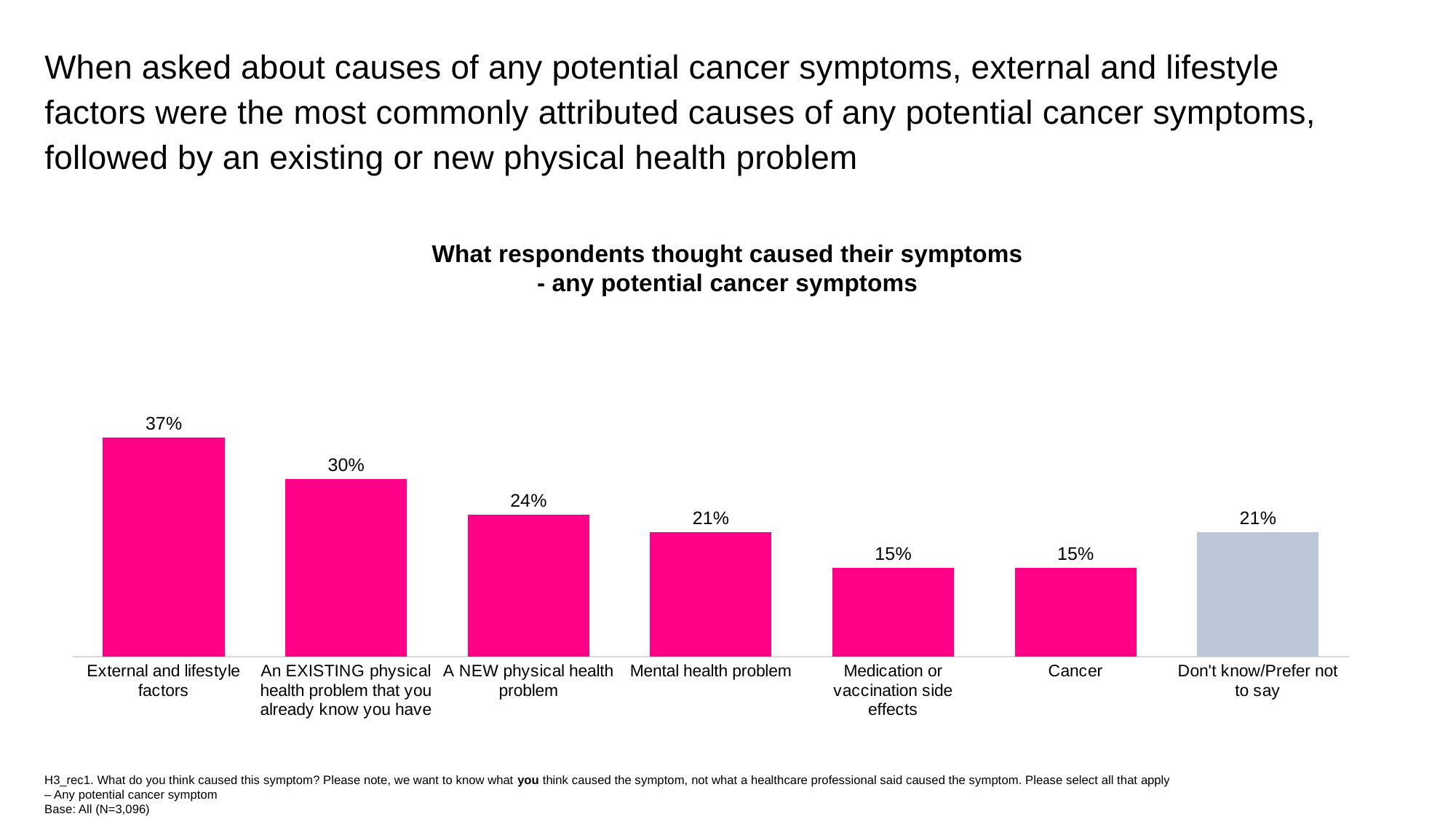
What is the value for 'Don't know/Prefer not to say'? 21% What is the value for 'A NEW physical health problem'? 24% How many categories are shown in the chart? 7 What kind of chart is shown on the slide? Bar chart What is the difference between the values for 'Mental health problem' and 'Cancer'? 6% What percentage of respondents thought cancer caused their symptoms? 15% Which category has the highest value? External and lifestyle factors What is the difference between the values for 'External and lifestyle factors' and 'An EXISTING physical health problem that you already know you have'? 7% What percentage of respondents attributed their symptoms to external and lifestyle factors? 37% Which is larger: the value for 'A NEW physical health problem' or the value for 'Mental health problem'? A NEW physical health problem Which bar is coloured differently (grey) from the others? Don't know/Prefer not to say What is the title of the chart? What respondents thought caused their symptoms - any potential cancer symptoms